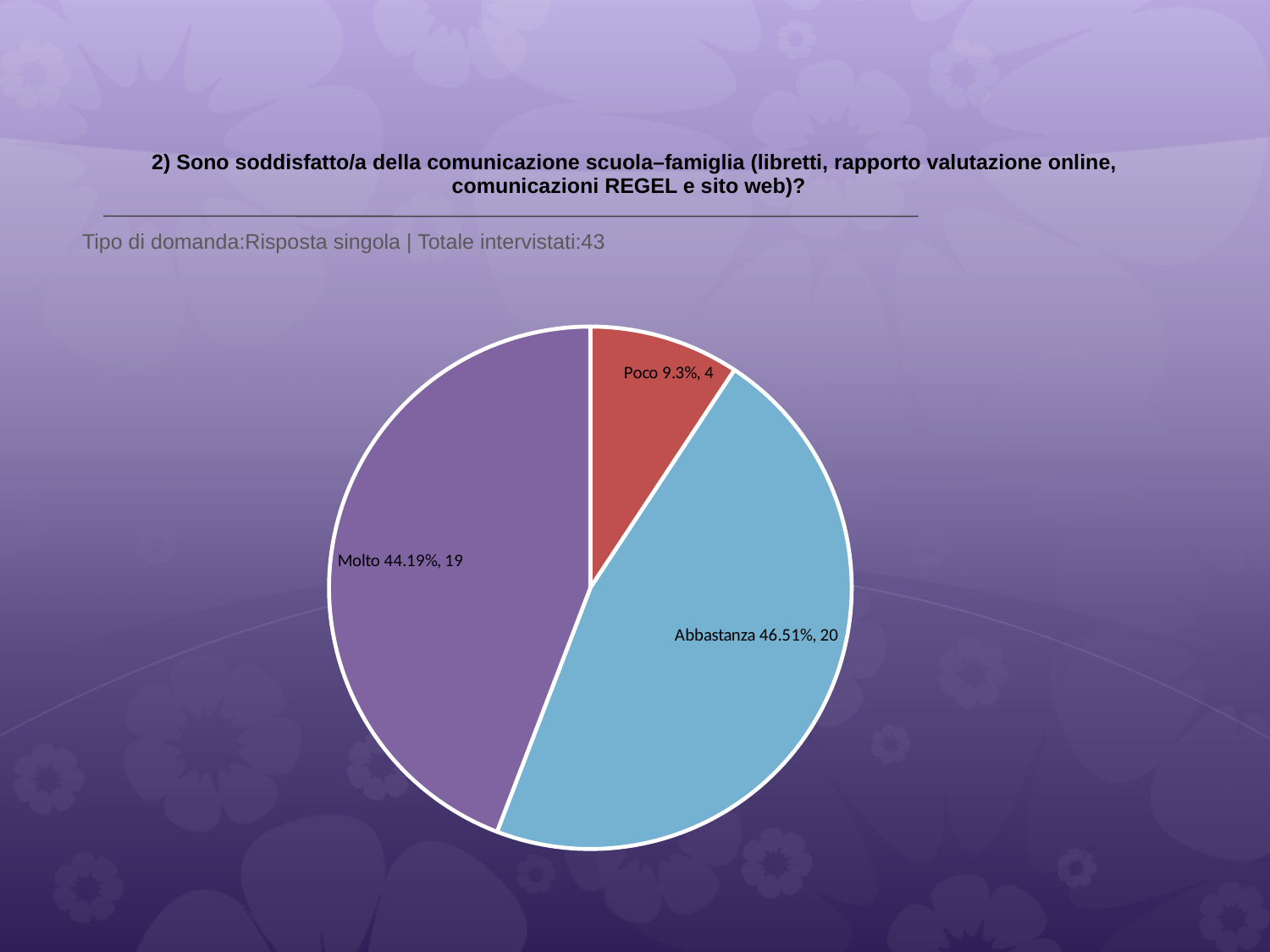
What percentage share does the Poco slice have? 9.3% How many slices does the pie chart have? 3 What percentage share does the Abbastanza slice have? 46.51% What kind of chart is shown on the slide? pie chart What colour is the Poco slice? red How many respondents answered Poco? 4 Which response has the smallest slice of the pie? Poco What is the difference in respondent count between Abbastanza and Poco? 16 How many respondents answered Abbastanza? 20 How many respondents answered Molto? 19 What percentage share does the Molto slice have? 44.19% Which has more respondents, Molto or Poco? Molto